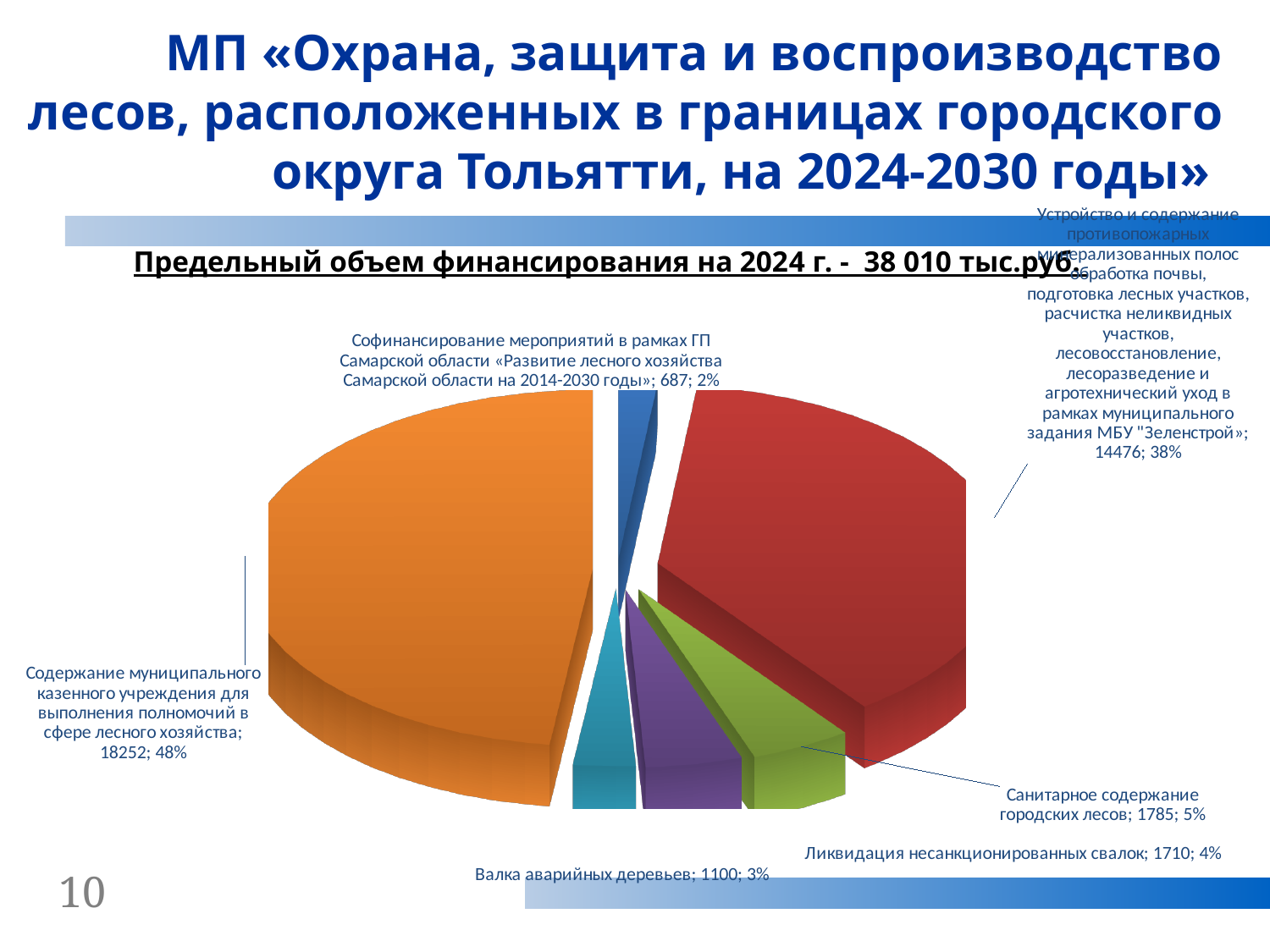
What kind of chart is shown on the slide? pie chart What value is shown for «Валка аварийных деревьев»? 1100 What is the difference between the values for «Санитарное содержание городских лесов» and «Ликвидация несанкционированных свалок»? 75 What is the total funding amount for 2024 stated on the slide? 38 010 тыс.руб. Which category has the largest slice of the pie? Содержание муниципального казенного учреждения для выполнения полномочий в сфере лесного хозяйства What share of the pie does «Ликвидация несанкционированных свалок» represent? 4% How many slices does the pie chart have? 6 What value is shown for «Содержание муниципального казенного учреждения для выполнения полномочий в сфере лесного хозяйства»? 18252 Which category has the smallest slice of the pie? Софинансирование мероприятий в рамках ГП Самарской области «Развитие лесного хозяйства Самарской области на 2014-2030 годы» What share of the pie does «Содержание муниципального казенного учреждения для выполнения полномочий в сфере лесного хозяйства» represent? 48% What value is shown for «Санитарное содержание городских лесов»? 1785 Which is larger: the value for «Валка аварийных деревьев» or the value for «Софинансирование мероприятий в рамках ГП Самарской области»? Валка аварийных деревьев